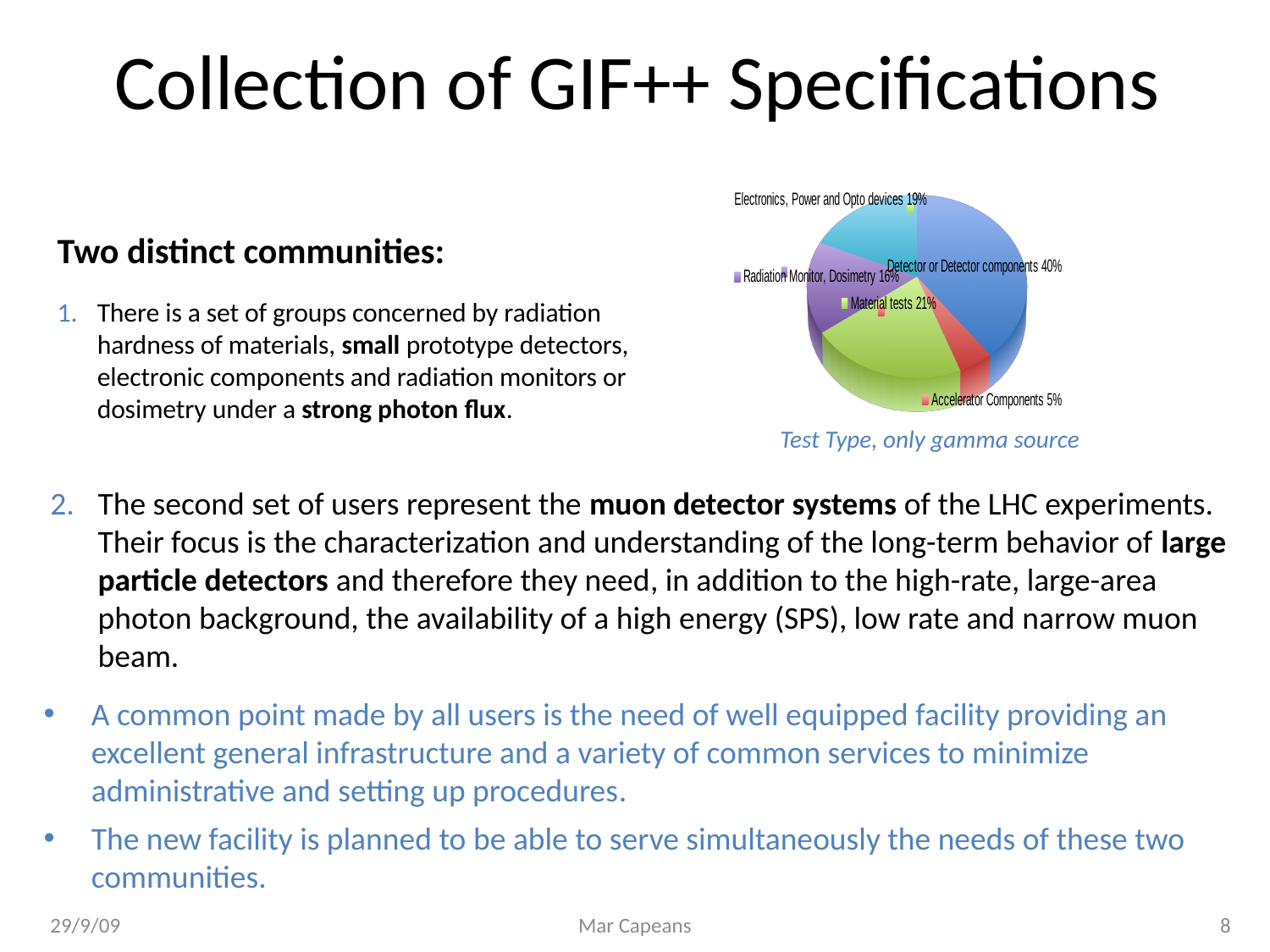
What is the caption written below the pie chart? Test Type, only gamma source What kind of chart is shown on the slide? pie chart Which is larger, the share for Material tests or the share for Radiation Monitor, Dosimetry? Material tests Which slice of the pie is the smallest? Accelerator Components What share of the pie does Electronics, Power and Opto devices have? 19% What share of the pie does Detector or Detector components have? 40% Which slice of the pie is the largest? Detector or Detector components What is the difference in percentage points between Detector or Detector components and Material tests? 19 How many slices does the pie chart have? 5 What share of the pie does Radiation Monitor, Dosimetry have? 16%